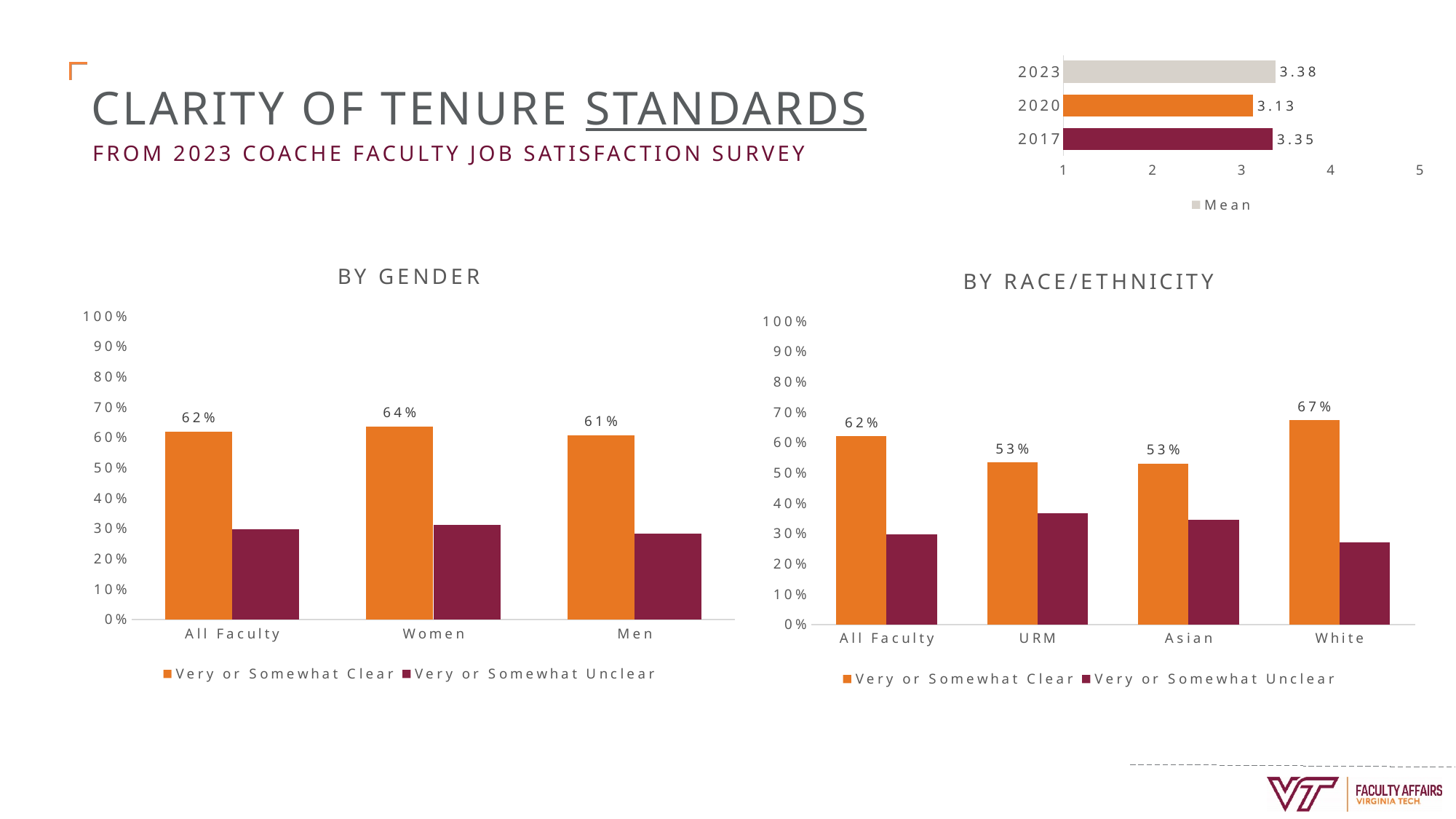
In the By Gender chart, is the Very or Somewhat Unclear value for Women greater or less than 40%? less In the By Race/Ethnicity chart, how many categories are shown on the x axis? 4 In the top-right Mean chart, which year has the lowest mean? 2020 In the By Race/Ethnicity chart, what is the difference between the Very or Somewhat Clear values for White and URM faculty? 14% In the By Gender chart, what percentage of Women report tenure standards are Very or Somewhat Clear? 64% In the By Race/Ethnicity chart, what is the Very or Somewhat Clear value for White faculty? 67% In the top-right Mean chart, what is the difference between the 2023 mean and the 2020 mean? 0.25 In the By Gender chart, which category has the lowest Very or Somewhat Clear value? Men In the By Race/Ethnicity chart, is the Very or Somewhat Unclear value for URM greater or less than 30%? greater In the By Gender chart, how many series does the legend list? 2 In the top-right Mean chart, what is the mean value for 2023? 3.38 What kind of chart is the By Gender chart? Bar chart